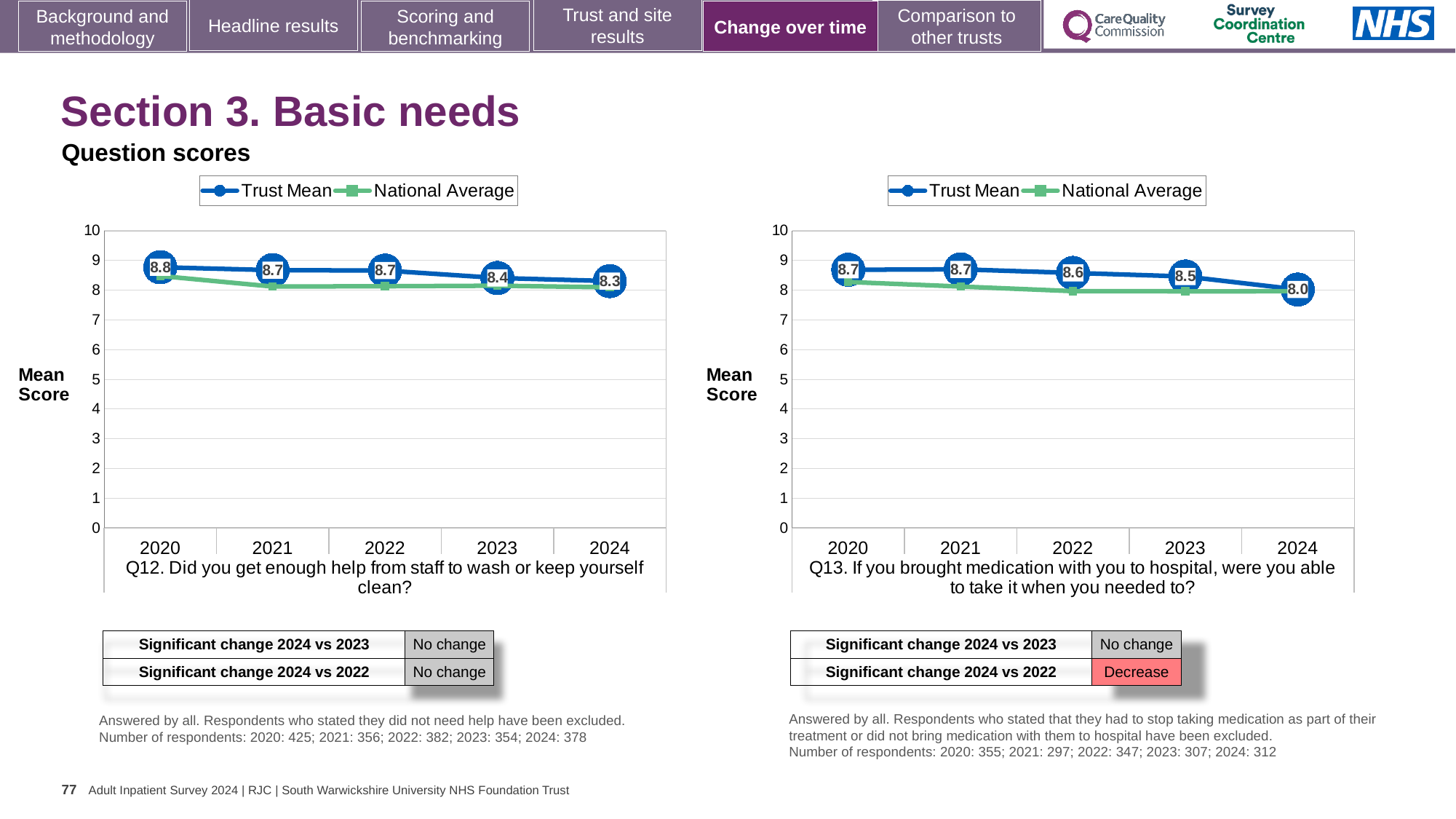
On the Q13 chart (right), which year has the lowest Trust Mean? 2024 On the Q12 chart (left), is the Trust Mean for 2023 larger or smaller than the Trust Mean for 2024? larger On the Q13 chart (right), what is the Trust Mean for 2022? 8.6 On the Q12 chart (left), is the National Average for 2024 greater or less than 9? less On the Q12 chart (left), what is the Trust Mean for 2020? 8.8 On the Q12 chart (left), which year has the highest Trust Mean? 2020 How many series does the legend of the Q12 chart (left) list? 2 On the Q13 chart (right), what is the difference between the Trust Mean for 2020 and 2024? 0.7 On the Q12 chart (left), what is the Trust Mean for 2024? 8.3 How many years are plotted on the Q13 chart (right)? 5 What type of chart is the Q13 chart (right)? line chart On the Q13 chart (right), what is the Trust Mean for 2024? 8.0